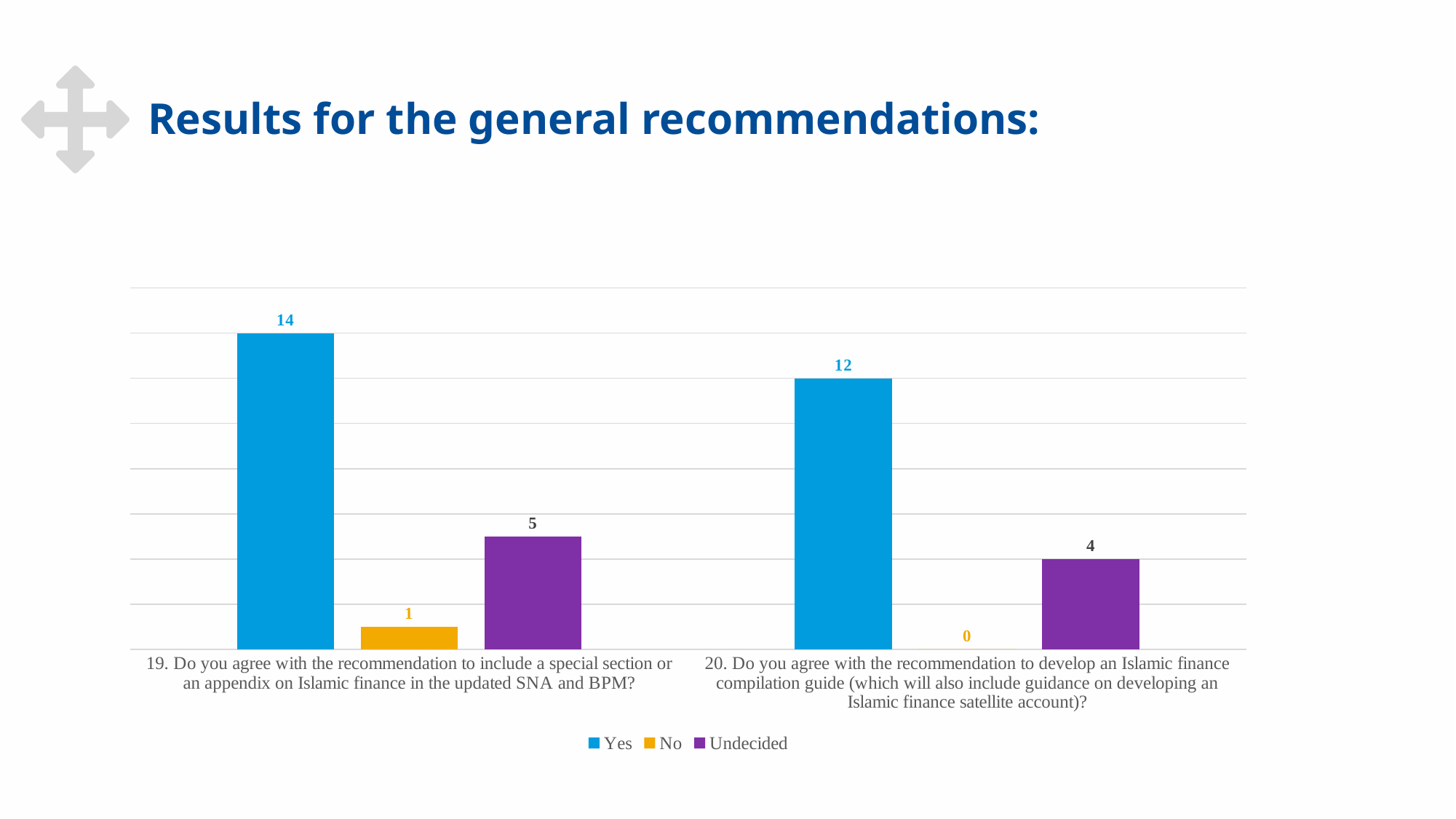
Which response category has the lowest count for question 19? No How many 'No' responses are shown for question 20 (develop an Islamic finance compilation guide)? 0 How many 'Yes' responses are shown for question 20? 12 How many 'Undecided' responses are shown for question 19? 5 What is the difference between the 'Yes' counts for question 19 and question 20? 2 Which response category has the highest count for question 20? Yes How many 'Yes' responses are shown for question 19 (include a special section or appendix on Islamic finance in the updated SNA and BPM)? 14 How many series does the legend list? 3 What colour represents the 'Undecided' series in the chart? Purple What type of chart is shown on the slide? Bar chart Which has more 'Undecided' responses, question 19 or question 20? Question 19 How many survey questions (categories) are shown on the x axis? 2